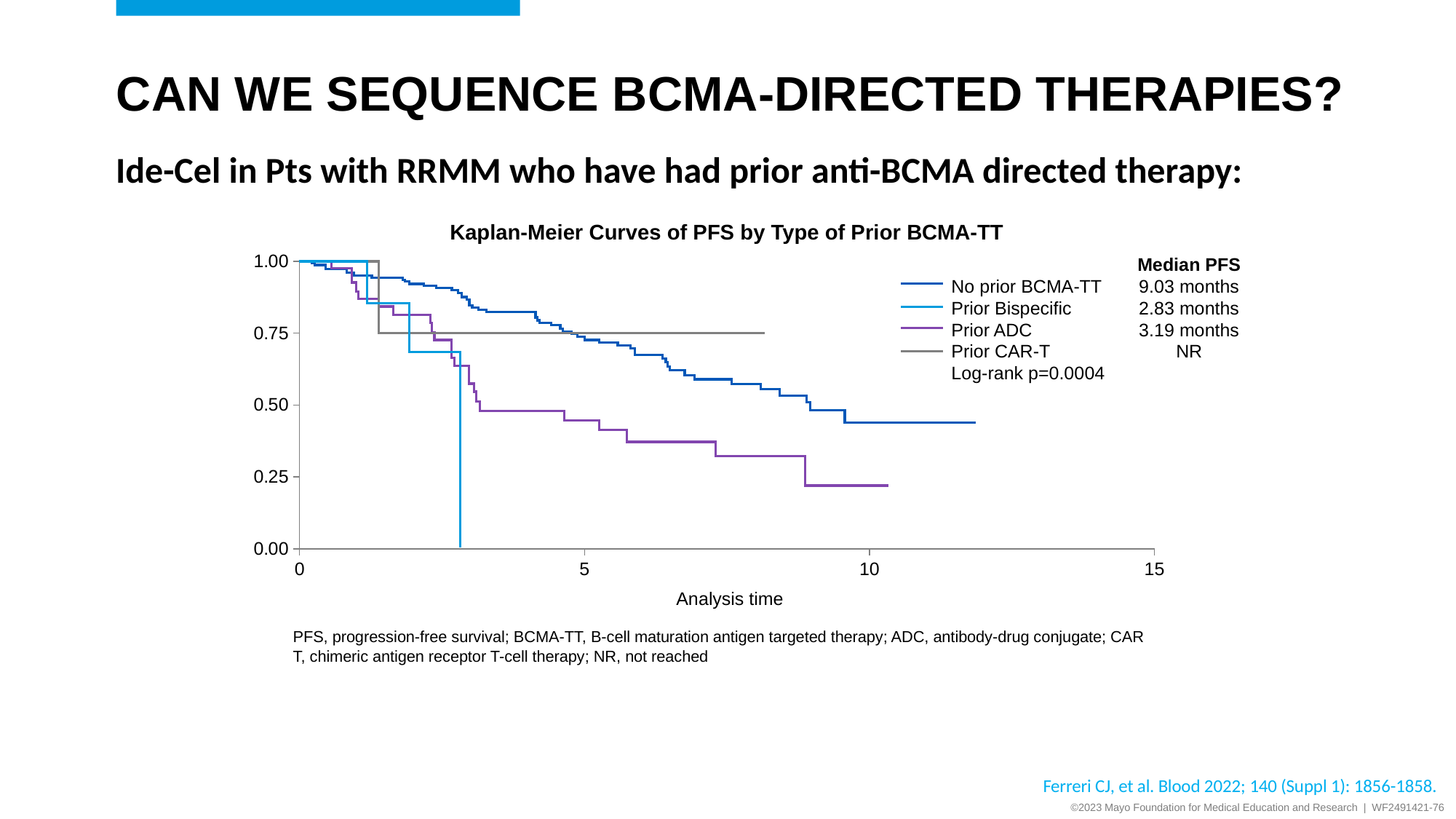
Which group has the longer median PFS, Prior ADC or Prior Bispecific? Prior ADC What is the median PFS for the Prior ADC group? 3.19 months Which group has the shortest median PFS? Prior Bispecific What kind of chart is shown on the slide? Line chart (Kaplan-Meier curves) What is the median PFS for the Prior CAR-T group? NR What is the median PFS for the Prior Bispecific group? 2.83 months Do the Kaplan-Meier curves rise or fall as analysis time increases? Fall What log-rank p-value is reported on the chart? p=0.0004 What is the difference in median PFS between the No prior BCMA-TT group and the Prior Bispecific group? 6.20 months How many groups (series) does the legend of the Kaplan-Meier chart list? 4 What is the median PFS for the No prior BCMA-TT group? 9.03 months At analysis time 10, is the PFS probability for the No prior BCMA-TT curve greater or less than 0.50? less